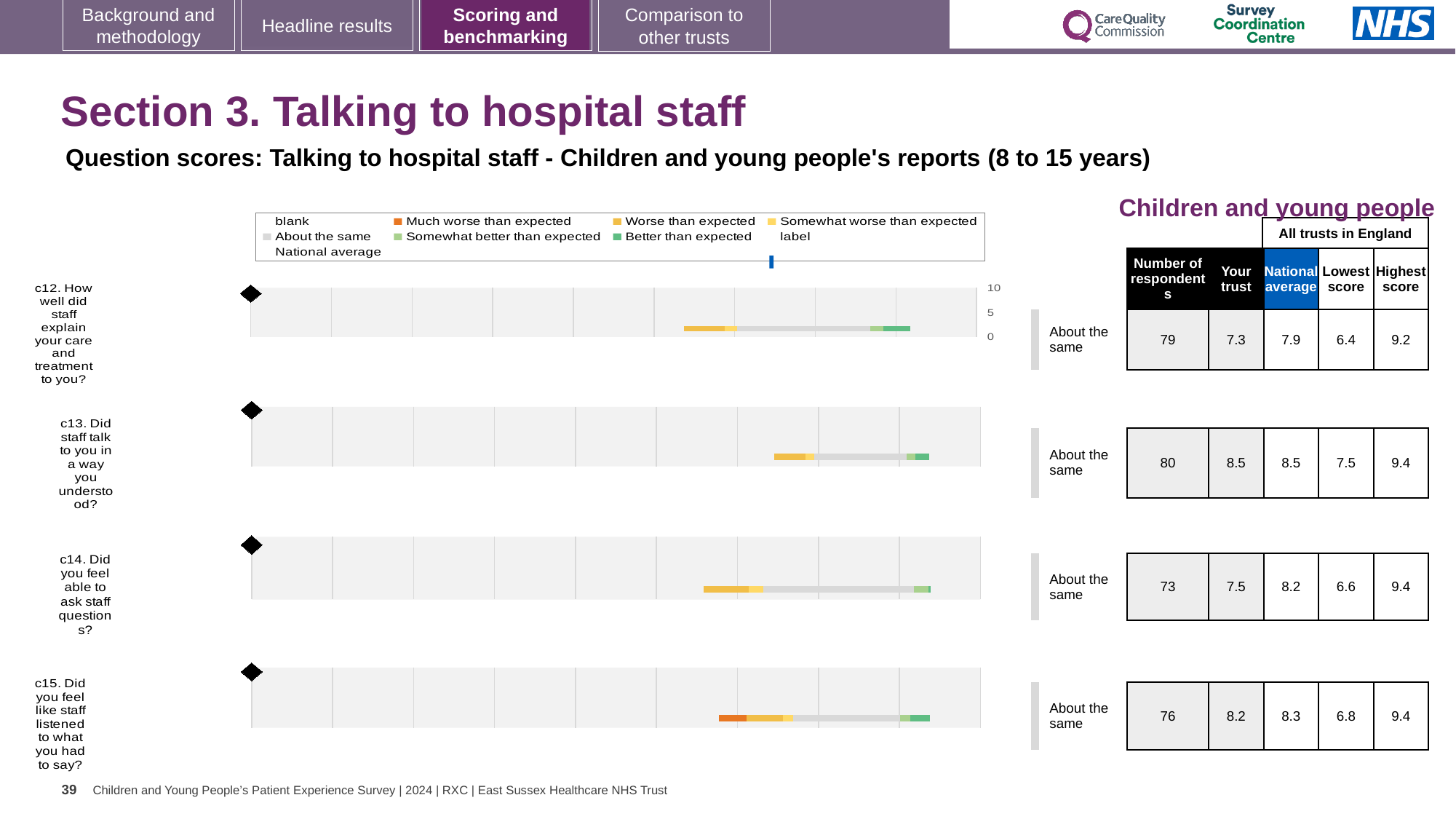
What is the maximum value shown on the chart axis? 10 What kind of chart is used to show the benchmarking results for question c12? bar chart For question c14, what is the difference between the national average and the 'Your trust' score? 0.7 For question c13, what is the 'Your trust' score? 8.5 Which question has the highest 'Your trust' score? c13 Which question has the lowest 'Your trust' score? c12 For question c15, what is the highest score among all trusts in England? 9.4 For question c15, is the 'Your trust' score higher or lower than the national average? lower What benchmark category label is shown next to the chart for question c12? About the same For question c12, how many respondents are shown in the table? 79 For question c14, what is the national average score? 8.2 How many questions (c12 to c15) have a benchmarking chart on this slide? 4